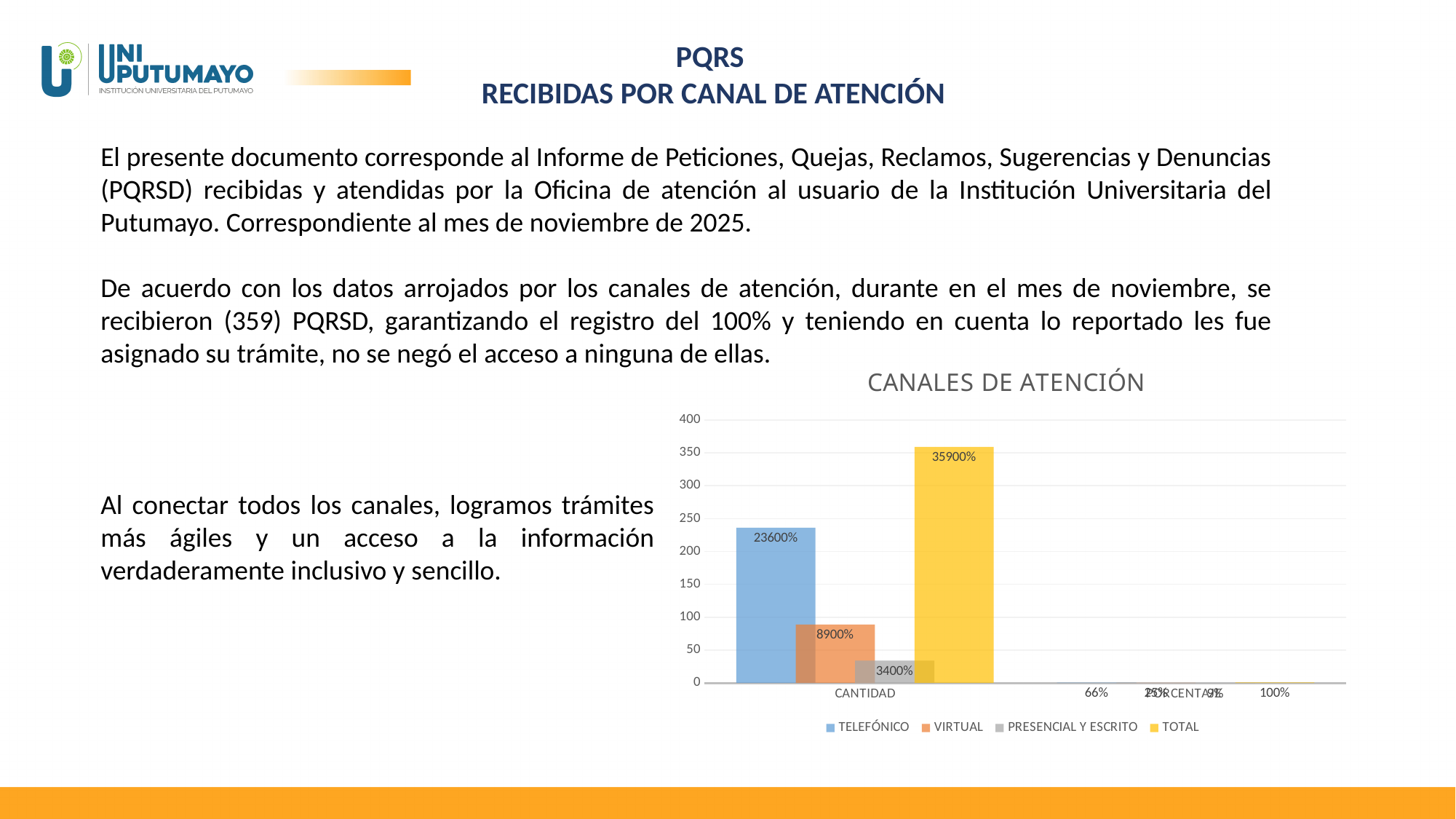
What is the data label for PRESENCIAL Y ESCRITO in the CANTIDAD category? 3400% Which series has the shortest bar in the CANTIDAD category? PRESENCIAL Y ESCRITO In the CANTIDAD category, which bar is taller: TELEFÓNICO or VIRTUAL? TELEFÓNICO How many categories are shown on the x axis of the chart? 2 What is the data label for TELEFÓNICO in the CANTIDAD category? 23600% What is the data label for VIRTUAL in the CANTIDAD category? 8900% What is the title of the chart? CANALES DE ATENCIÓN Which series has the tallest bar in the CANTIDAD category? TOTAL What kind of chart is shown on the slide? bar chart Is the TELEFÓNICO bar in the CANTIDAD category greater or less than 200 on the y axis? greater What is the data label for TOTAL in the CANTIDAD category? 35900% How many series does the chart legend list? 4